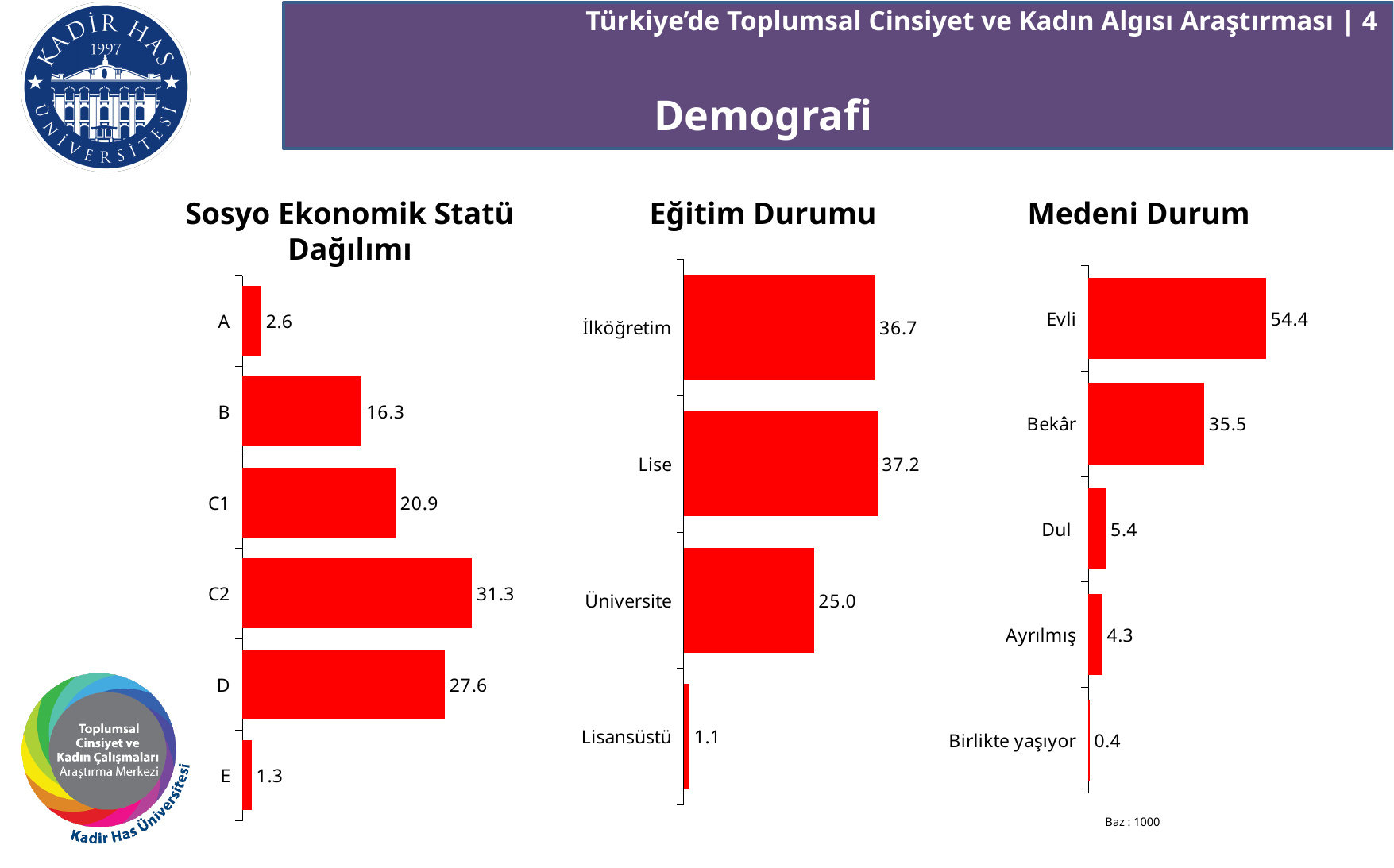
In the 'Medeni Durum' chart, which is larger, the value for Dul or the value for Ayrılmış? Dul In the 'Sosyo Ekonomik Statü Dağılımı' chart, which category has the lowest value? E In the 'Sosyo Ekonomik Statü Dağılımı' chart, how many categories are shown? 6 What kind of chart is the 'Medeni Durum' chart? Bar chart In the 'Eğitim Durumu' chart, what is the value for Üniversite? 25.0 In the 'Eğitim Durumu' chart, what is the difference between the values for Lise and İlköğretim? 0.5 In the 'Medeni Durum' chart, which category has the lowest value? Birlikte yaşıyor In the 'Eğitim Durumu' chart, which category has the highest value? Lise In the 'Sosyo Ekonomik Statü Dağılımı' chart, what is the value for C2? 31.3 What base size (Baz) is noted on the slide? 1000 In the 'Sosyo Ekonomik Statü Dağılımı' chart, what is the difference between the values for D and B? 11.3 In the 'Medeni Durum' chart, what is the value for Bekâr? 35.5